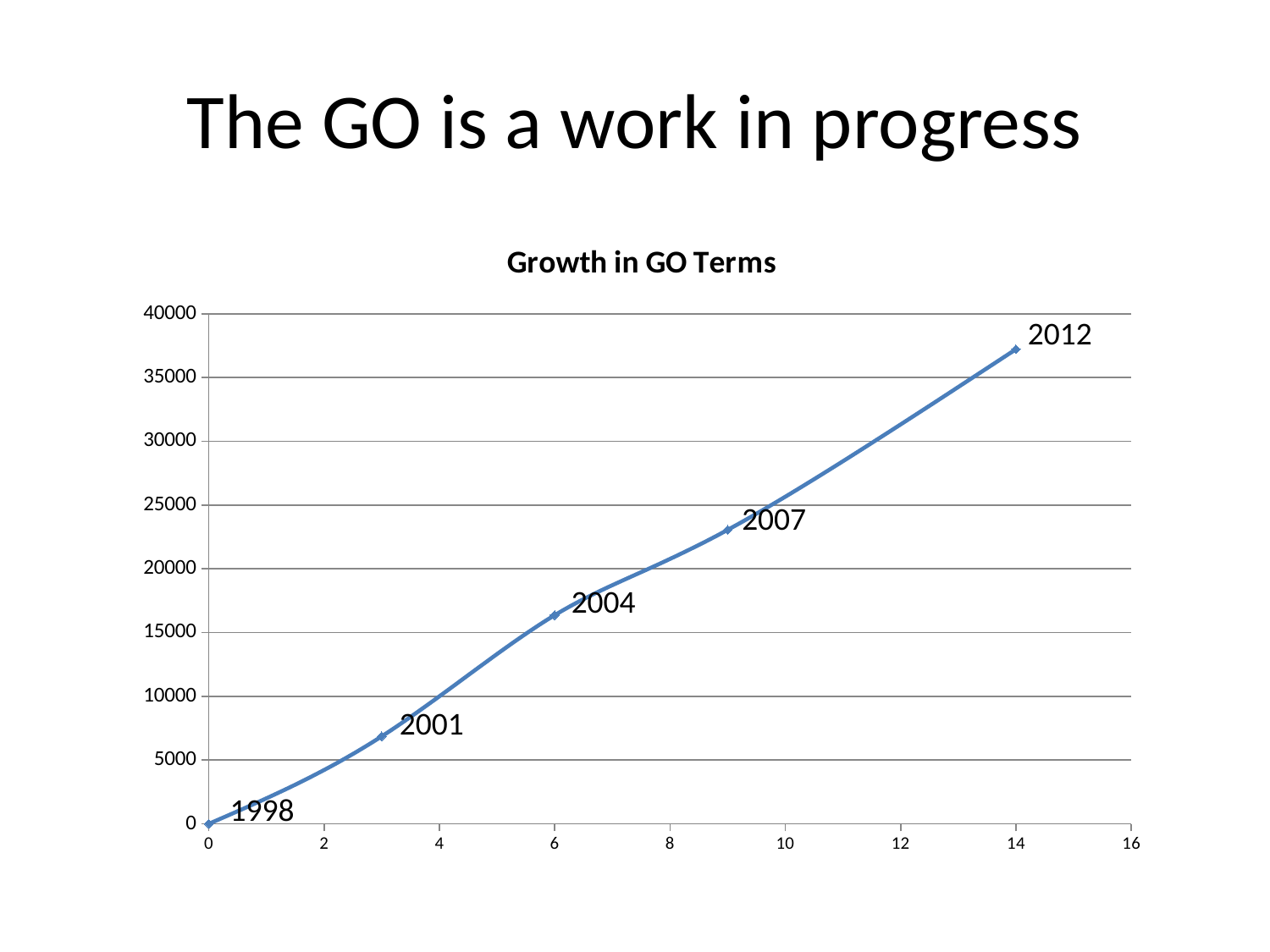
Is the value for 2001 greater or less than 10000? less Which labelled year has the highest value on the chart? 2012 What is the value plotted for 1998? 0 Do the values rise or fall as you move from left to right along the x axis? rise Is the value for 2004 greater or less than 15000? greater Is the value for 2007 greater or less than 25000? less Which labelled year has the lowest value on the chart? 1998 How many labelled data points are plotted on the line? 5 Which has the larger value, 2004 or 2007? 2007 What is the title of the chart? Growth in GO Terms What kind of chart is shown on the slide? line chart